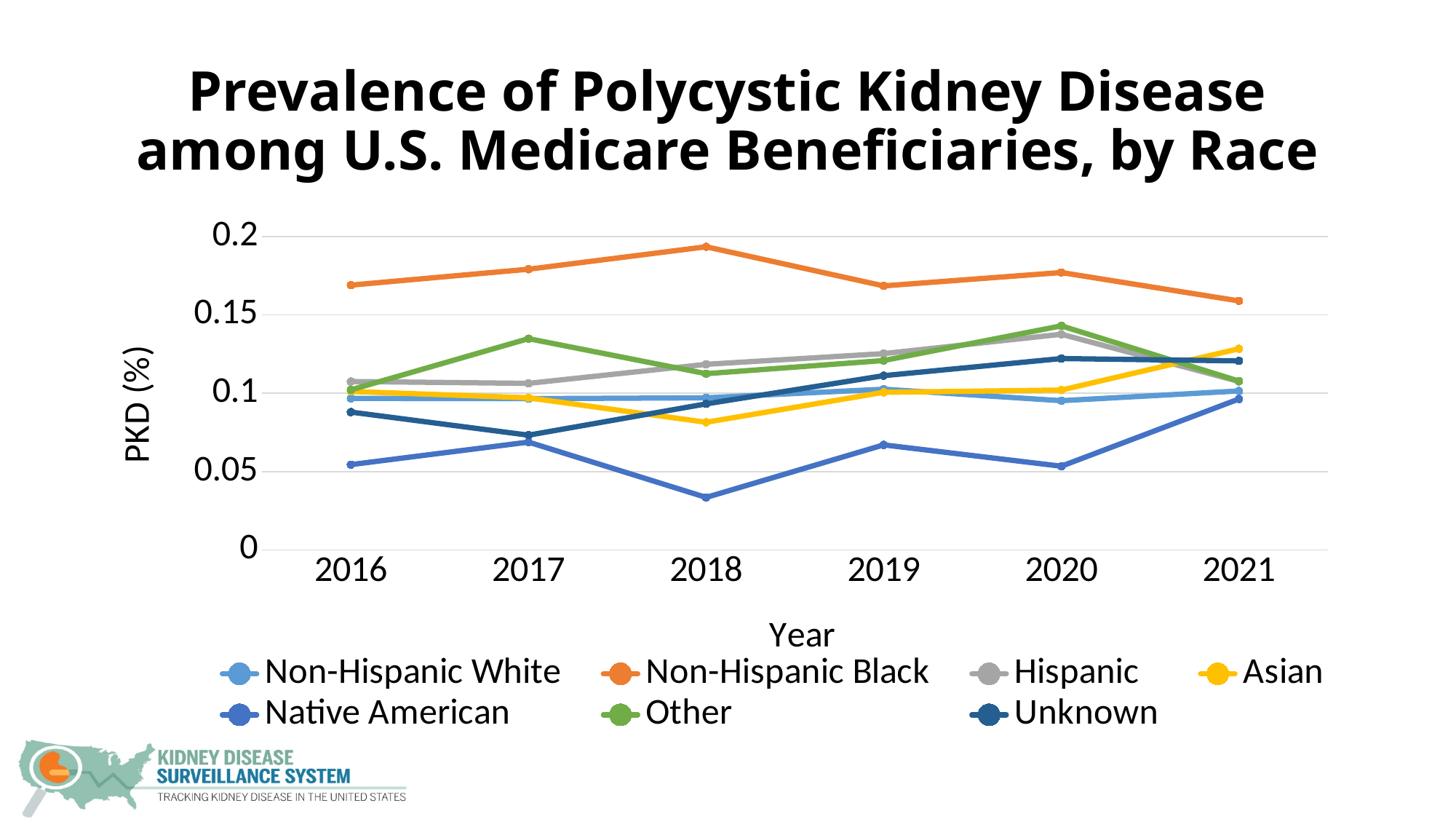
What kind of chart is shown on the slide? line chart Which race group has the highest PKD prevalence in 2018? Non-Hispanic Black Is the value for Non-Hispanic Black in 2018 greater or less than 0.15? greater Does the Non-Hispanic Black line rise or fall from 2020 to 2021? fall Which race group has the lowest PKD prevalence in 2018? Native American In 2021, which is larger: the value for Asian or the value for Other? Asian Is the value for Native American in 2018 greater or less than 0.05? less How many series does the legend list? 7 How many years are shown on the x axis? 6 What is the label on the y axis? PKD (%) In 2017, which is larger: the value for Other or the value for Hispanic? Other Is the value for Unknown in 2016 greater or less than 0.1? less